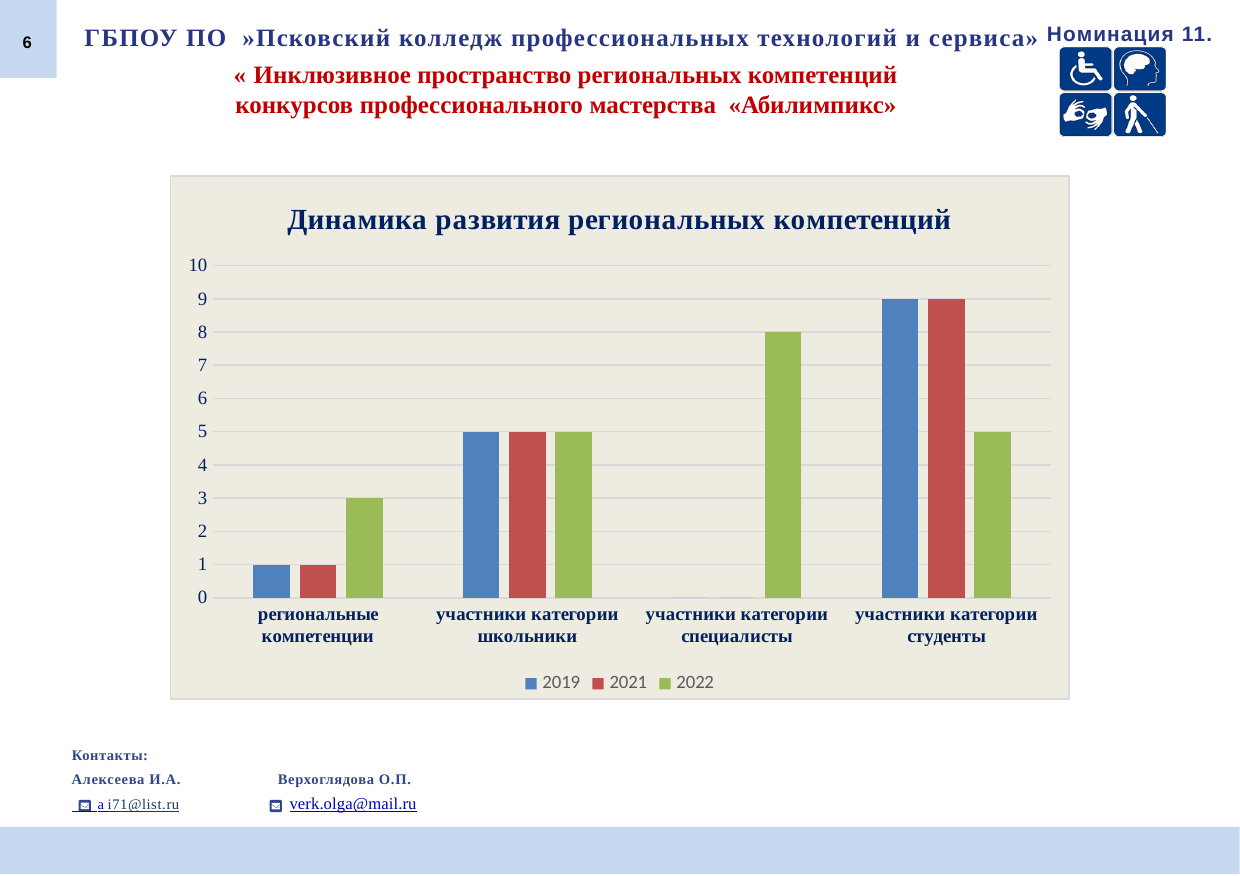
Which category has the lowest value for the 2022 series? региональные компетенции How many categories are shown on the x axis? 4 What kind of chart is shown on the slide? bar chart What is the value for 2022 in the category "участники категории школьники"? 5 Which is larger: the 2022 value for "участники категории специалисты" or the 2022 value for "участники категории студенты"? участники категории специалисты What is the difference between the 2021 and 2022 values for "участники категории студенты"? 4 What is the value for 2019 in the category "участники категории студенты"? 9 How many series does the legend list? 3 Which category has the highest value for the 2019 series? участники категории студенты What is the value for 2022 in the category "региональные компетенции"? 3 What is the value for 2022 in the category "участники категории специалисты"? 8 What is the title of the chart? Динамика развития региональных компетенций